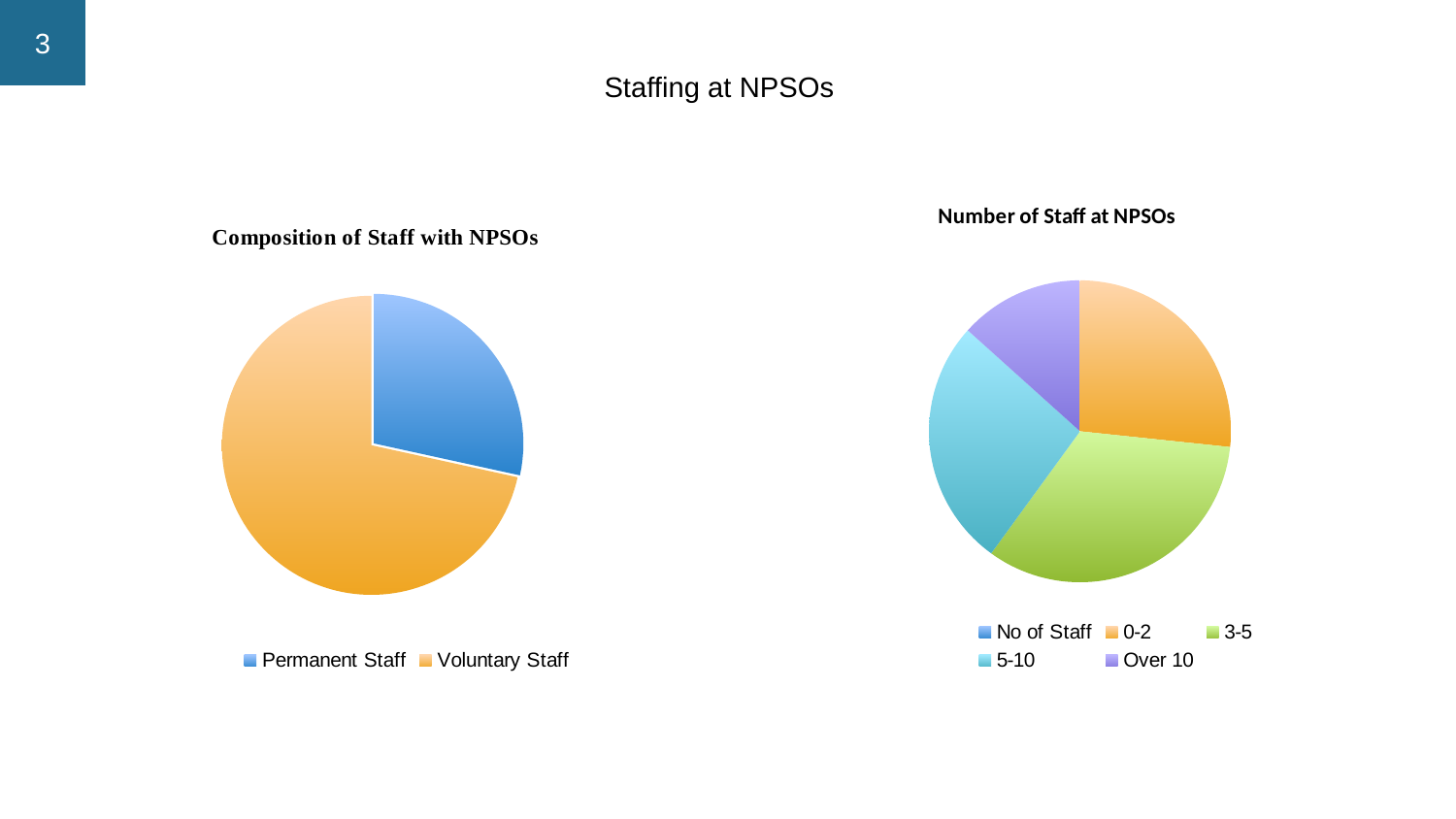
In the 'Number of Staff at NPSOs' chart, which is larger: the 5-10 slice or the Over 10 slice? 5-10 What kind of chart is the 'Composition of Staff with NPSOs' chart? Pie chart In the 'Composition of Staff with NPSOs' chart, which category has the largest slice? Voluntary Staff In the 'Composition of Staff with NPSOs' chart, what colour is the Voluntary Staff slice? Orange How many categories does the legend of the 'Composition of Staff with NPSOs' chart list? 2 In the 'Number of Staff at NPSOs' chart, which is larger: the 3-5 slice or the 0-2 slice? 3-5 In the 'Composition of Staff with NPSOs' chart, which category has the smallest slice? Permanent Staff How many entries does the legend of the 'Number of Staff at NPSOs' chart list? 5 What kind of chart is the 'Number of Staff at NPSOs' chart? Pie chart In the 'Number of Staff at NPSOs' chart, which visible slice is the smallest? Over 10 In the 'Number of Staff at NPSOs' chart, which category has the largest slice? 3-5 In the 'Composition of Staff with NPSOs' chart, which is larger: Permanent Staff or Voluntary Staff? Voluntary Staff